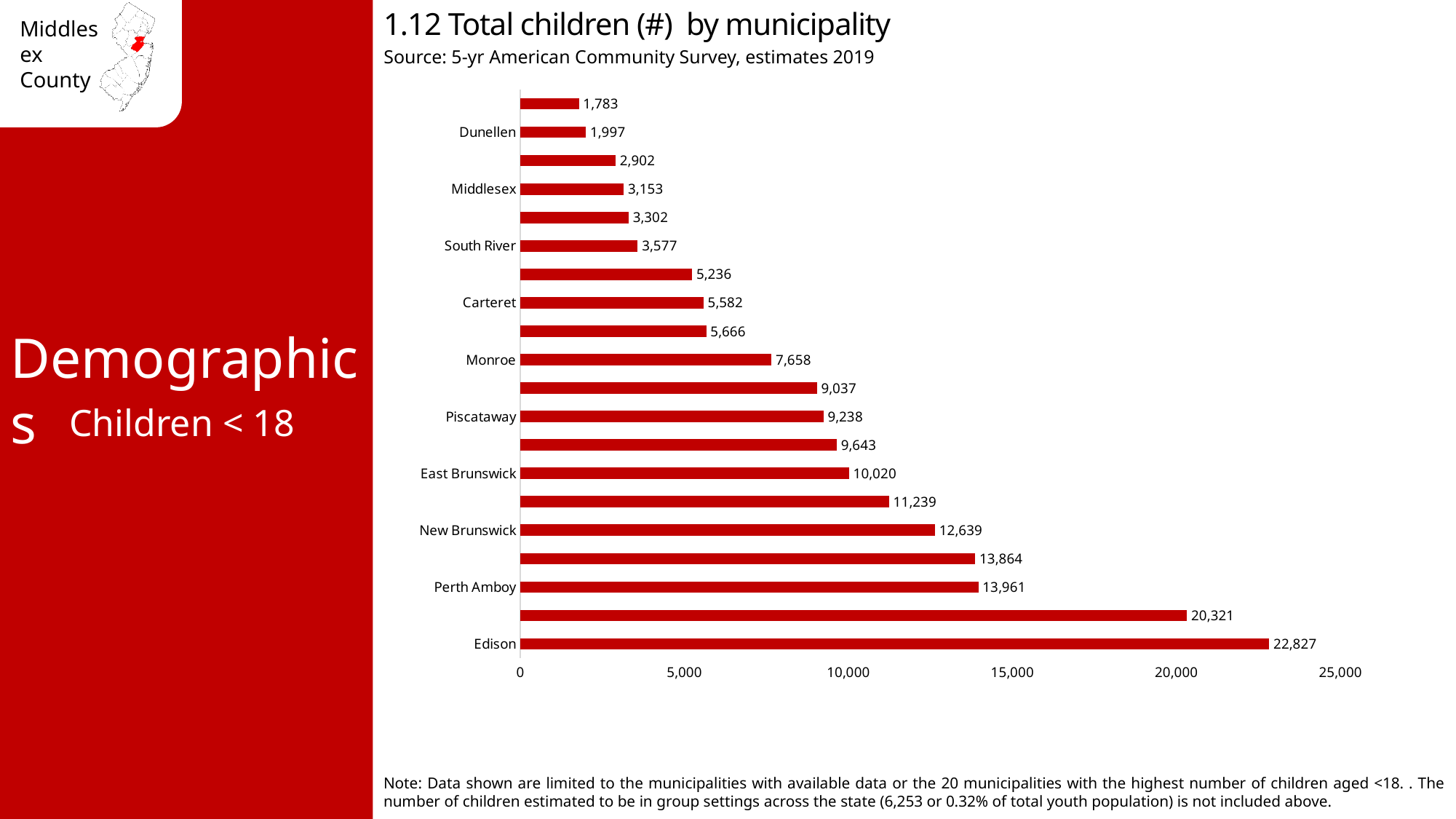
How many bars are plotted in the chart? 20 What is the difference between the values for Edison and Perth Amboy? 8,866 What is the title of the chart? 1.12 Total children (#) by municipality What is the total number of children for Piscataway? 9,238 Is the value for Monroe greater or less than 10,000? less What is the total number of children for Edison? 22,827 What is the total number of children for Dunellen? 1,997 Which has more children, New Brunswick or East Brunswick? New Brunswick Which labeled municipality has the highest number of children? Edison What is the total number of children for Perth Amboy? 13,961 What type of chart is shown on the slide? bar chart What is the smallest value shown on any bar in the chart? 1,783